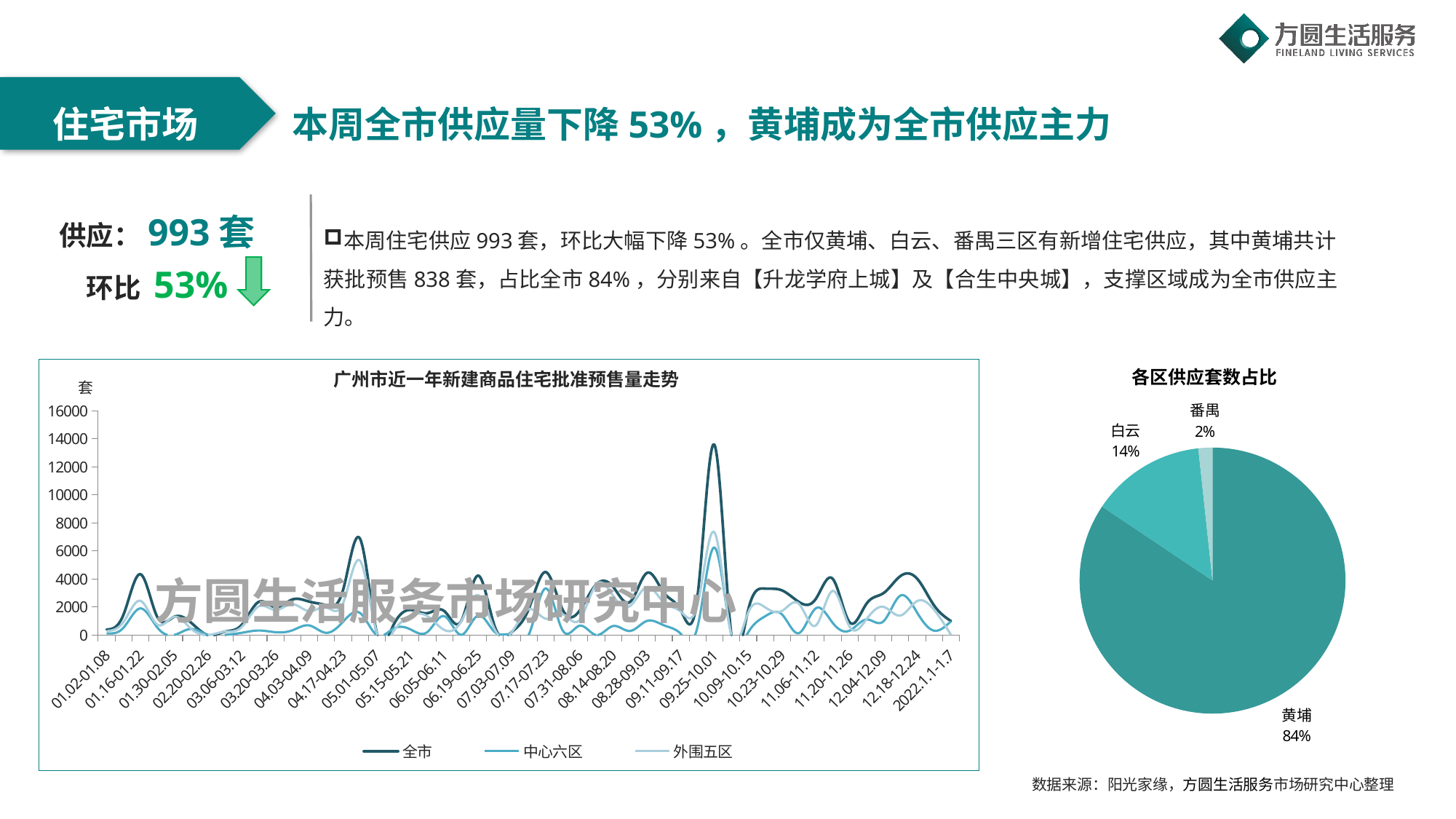
In the pie chart 各区供应套数占比, which district has the largest share? 黄埔 In the line chart 广州市近一年新建商品住宅批准预售量走势, what are the three series named in the legend? 全市, 中心六区, 外围五区 What kind of chart is the chart on the right titled 各区供应套数占比? Pie chart In the pie chart 各区供应套数占比, what share does 番禺 have? 2% What kind of chart is the chart on the left titled 广州市近一年新建商品住宅批准预售量走势? Line chart In the pie chart 各区供应套数占比, how many districts are shown? 3 In the pie chart 各区供应套数占比, which district has the smallest share? 番禺 In the line chart 广州市近一年新建商品住宅批准预售量走势, is the value of 全市 for the period 09.25-10.01 greater or less than 12000? greater In the pie chart 各区供应套数占比, how many percentage points larger is 黄埔's share than 白云's? 70 In the pie chart 各区供应套数占比, what share does 黄埔 have? 84% In the line chart 广州市近一年新建商品住宅批准预售量走势, how many series does the legend list? 3 In the pie chart 各区供应套数占比, what share does 白云 have? 14%